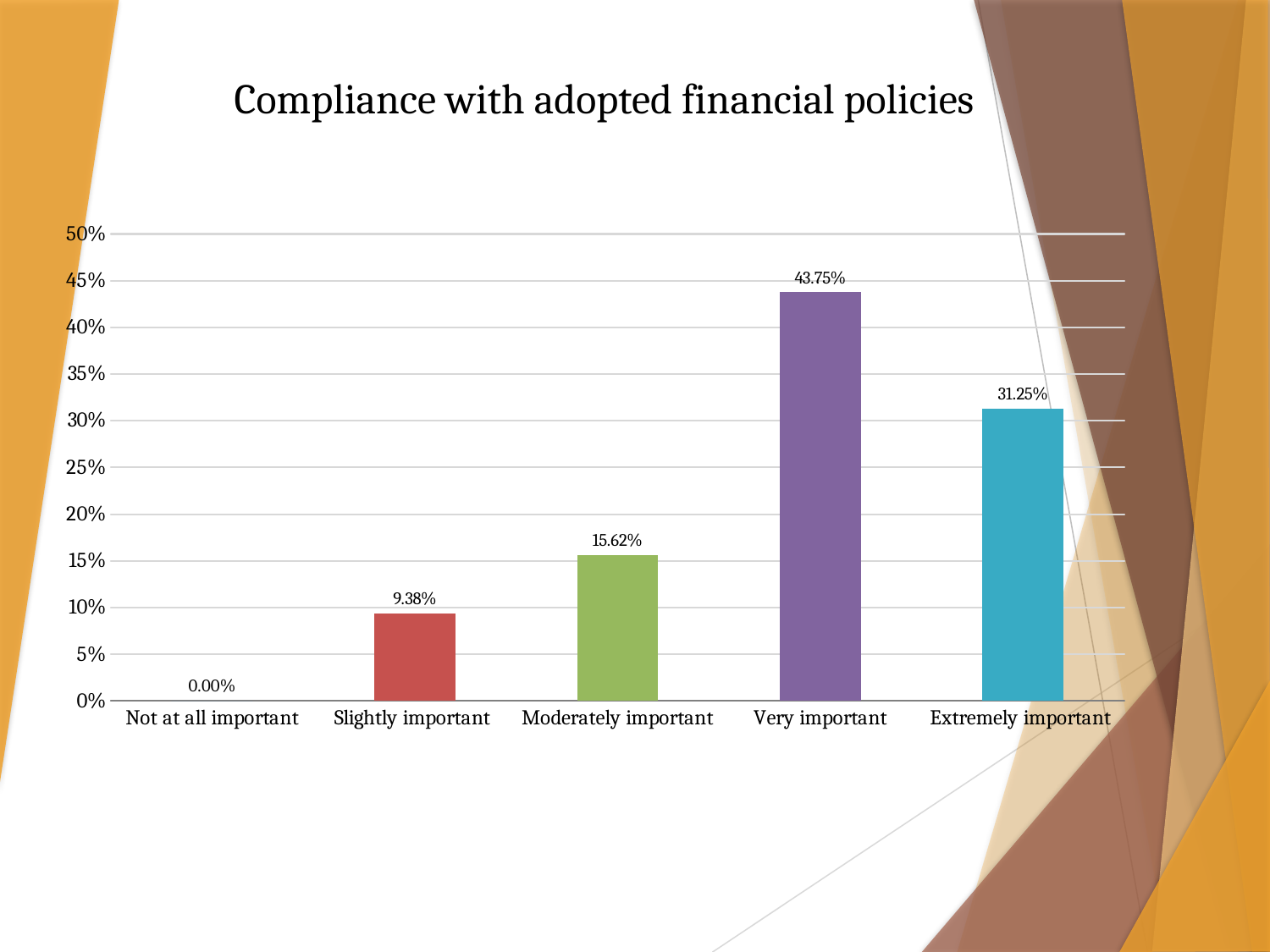
What kind of chart is shown on the slide? bar chart What is the difference between the values for Very important and Extremely important? 12.50% What is the title of the chart? Compliance with adopted financial policies What is the value for Very important? 43.75% What is the value for Not at all important? 0.00% Is the value for Extremely important greater or less than 30%? greater Which category has the highest value? Very important Which is larger, the value for Moderately important or the value for Slightly important? Moderately important Which category has the lowest value? Not at all important What is the value for Moderately important? 15.62% What is the value for Slightly important? 9.38% How many categories are shown on the x axis? 5